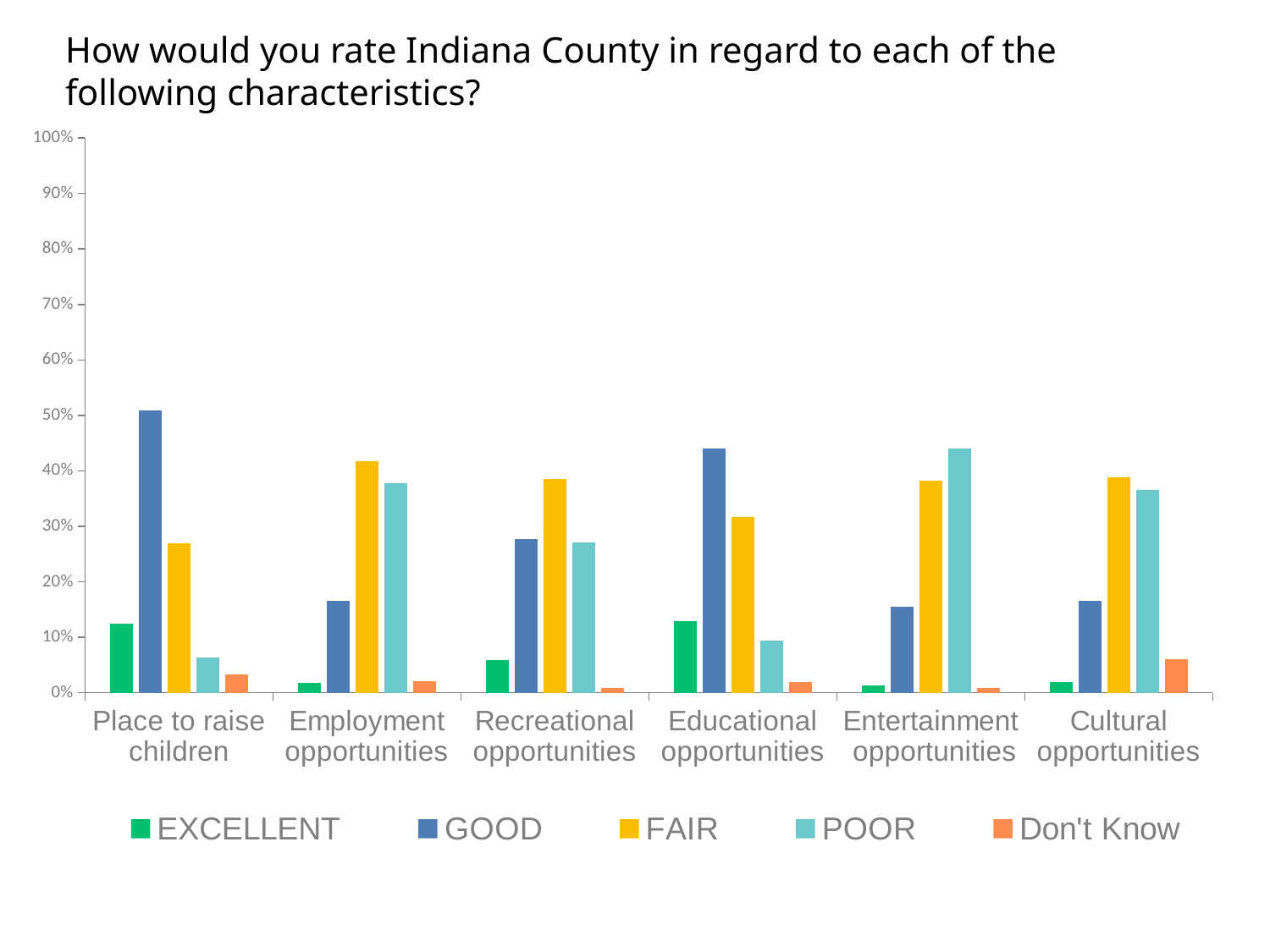
For Entertainment opportunities, which is larger: the POOR value or the GOOD value? POOR Which characteristic has the highest POOR rating? Entertainment opportunities Which rating series has the lowest value for Recreational opportunities? Don't Know Is the FAIR value for Employment opportunities greater or less than 30%? greater Which characteristic has the highest GOOD rating? Place to raise children How many characteristics (categories) are shown along the x axis? 6 What colour represents the FAIR series in the legend? Yellow For Educational opportunities, which is larger: the GOOD value or the FAIR value? GOOD How many series does the legend list? 5 Is the EXCELLENT value for Place to raise children greater or less than 10%? greater Is the GOOD value for Place to raise children greater or less than 40%? greater What kind of chart is shown on the slide? Bar chart